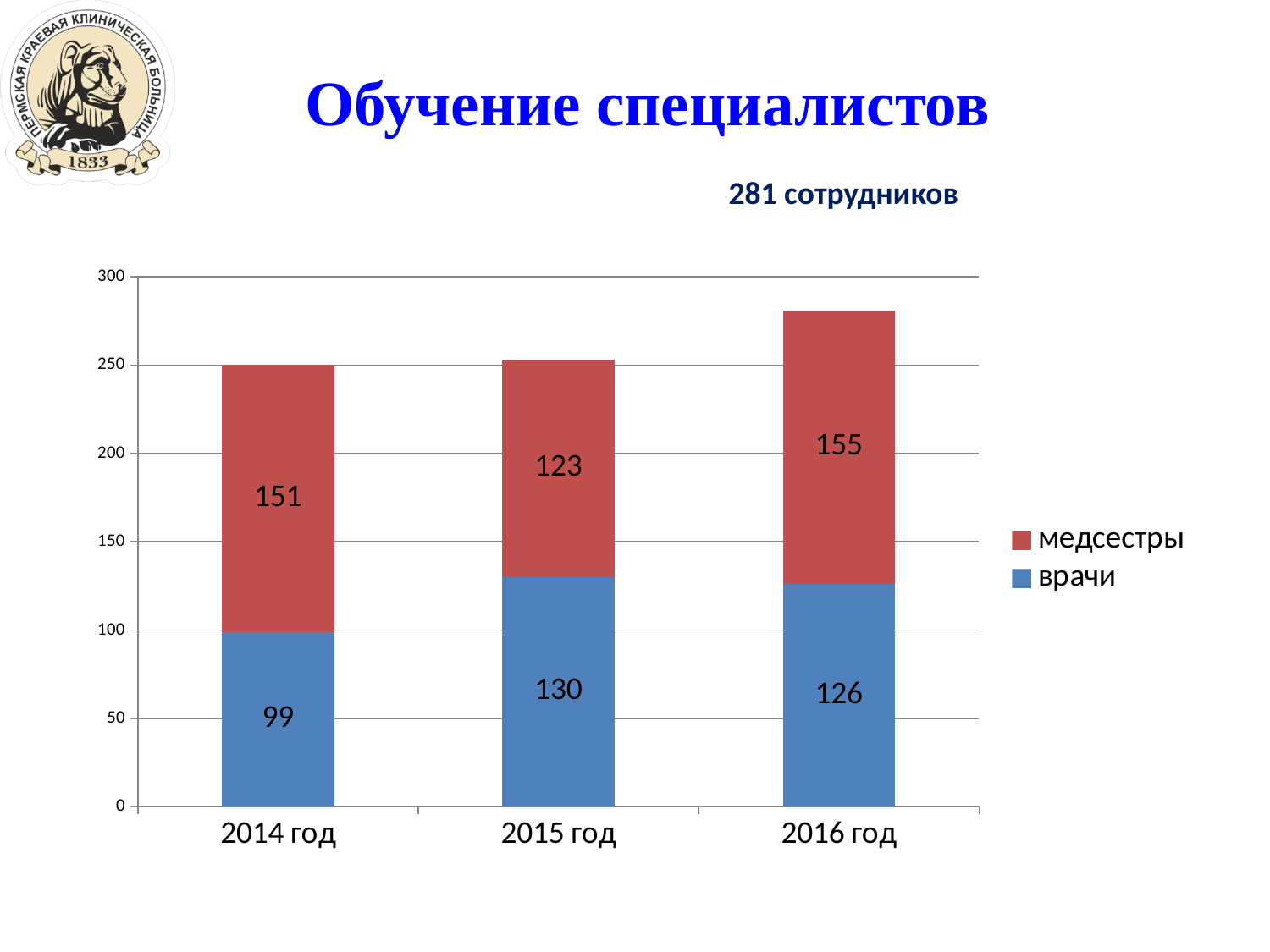
In which year is the value for медсестры highest? 2016 год How many series does the legend list? 2 How many years are shown on the x axis? 3 What is the total of the stacked bar for 2016 год? 281 What kind of chart is shown on the slide? Stacked bar chart What is the value for врачи in 2015 год? 130 What is the value for медсестры in 2016 год? 155 In which year is the value for врачи lowest? 2014 год Which is larger: врачи in 2015 год or врачи in 2016 год? врачи in 2015 год What is the value for врачи in 2014 год? 99 What is the difference between медсестры in 2016 год and медсестры in 2015 год? 32 What is the total of the stacked bar for 2014 год? 250